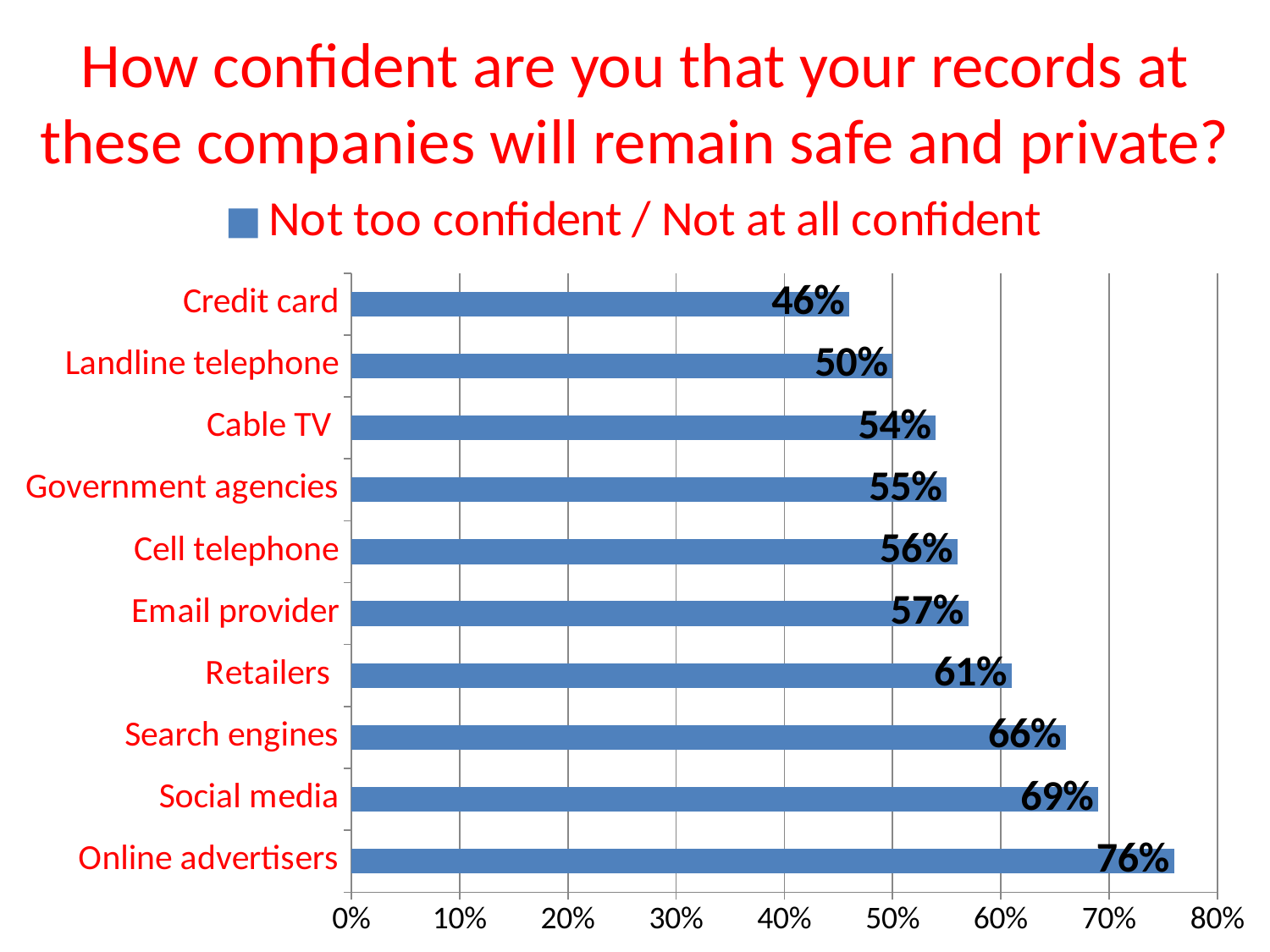
How many categories are shown in the chart? 10 What is the value for Online advertisers? 76% Which is larger, the value for Retailers or the value for Email provider? Retailers What is the value for Credit card? 46% What is the legend entry for the series shown? Not too confident / Not at all confident Which category has the lowest value? Credit card What is the value for Government agencies? 55% Which category has the highest value? Online advertisers How many series does the legend list? 1 Is the value for Cable TV greater or less than 50%? greater What kind of chart is shown on the slide? Bar chart What is the difference between the values for Social media and Search engines? 3%